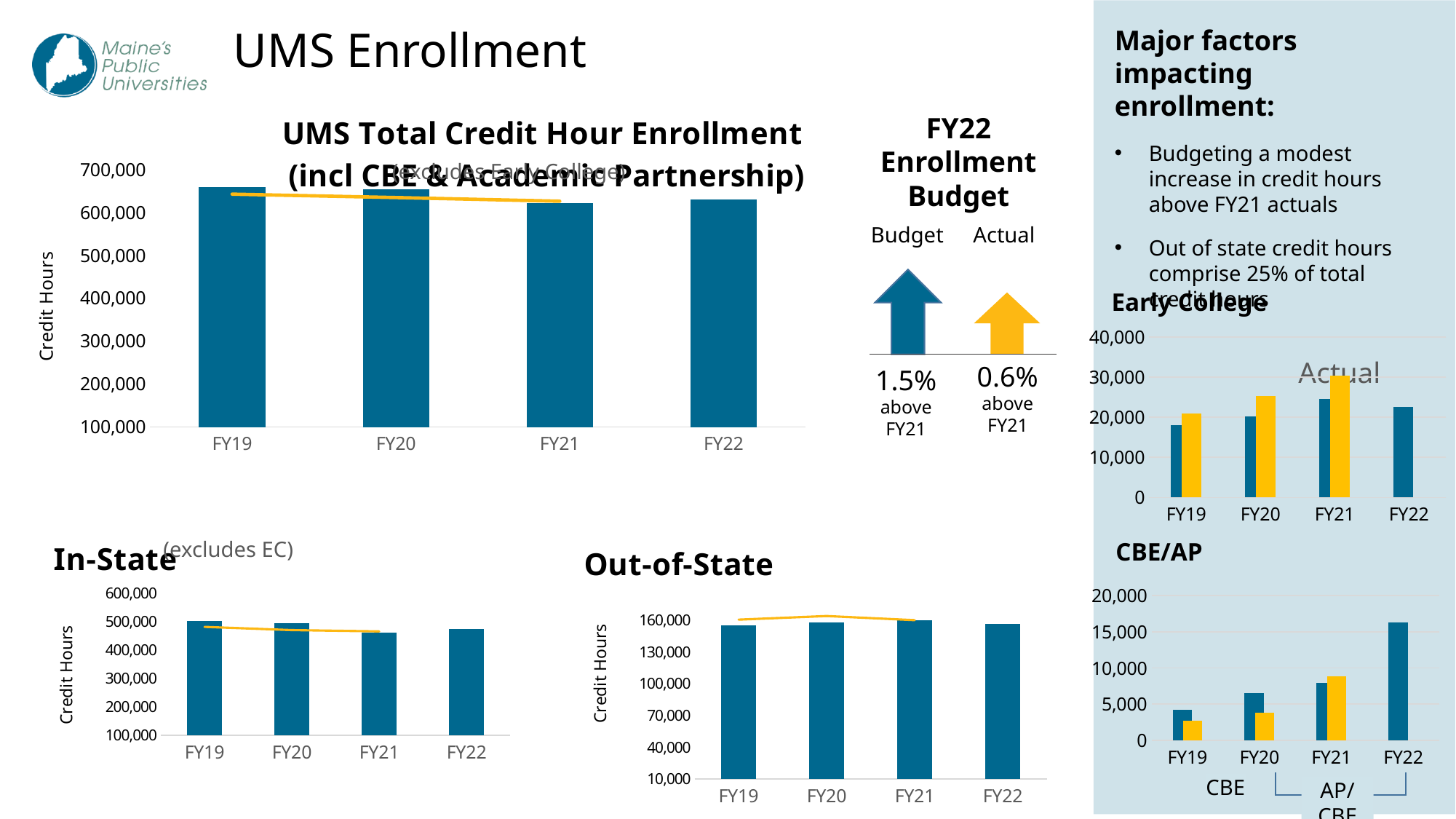
On the UMS Total Credit Hour Enrollment chart, which fiscal year has the lowest credit hours? FY21 On the In-State chart, is the value for FY19 greater or less than 400,000? greater What kind of chart is the UMS Total Credit Hour Enrollment chart? combination bar and line chart On the UMS Total Credit Hour Enrollment chart, is the value for FY21 greater or less than 600,000? greater On the Early College chart, is the yellow (Actual) bar for FY21 greater or less than 20,000? greater On the In-State chart, which fiscal year has the lowest credit hours? FY21 On the CBE/AP chart, which fiscal year has the tallest bar? FY22 How many fiscal years are shown on the UMS Total Credit Hour Enrollment chart? 4